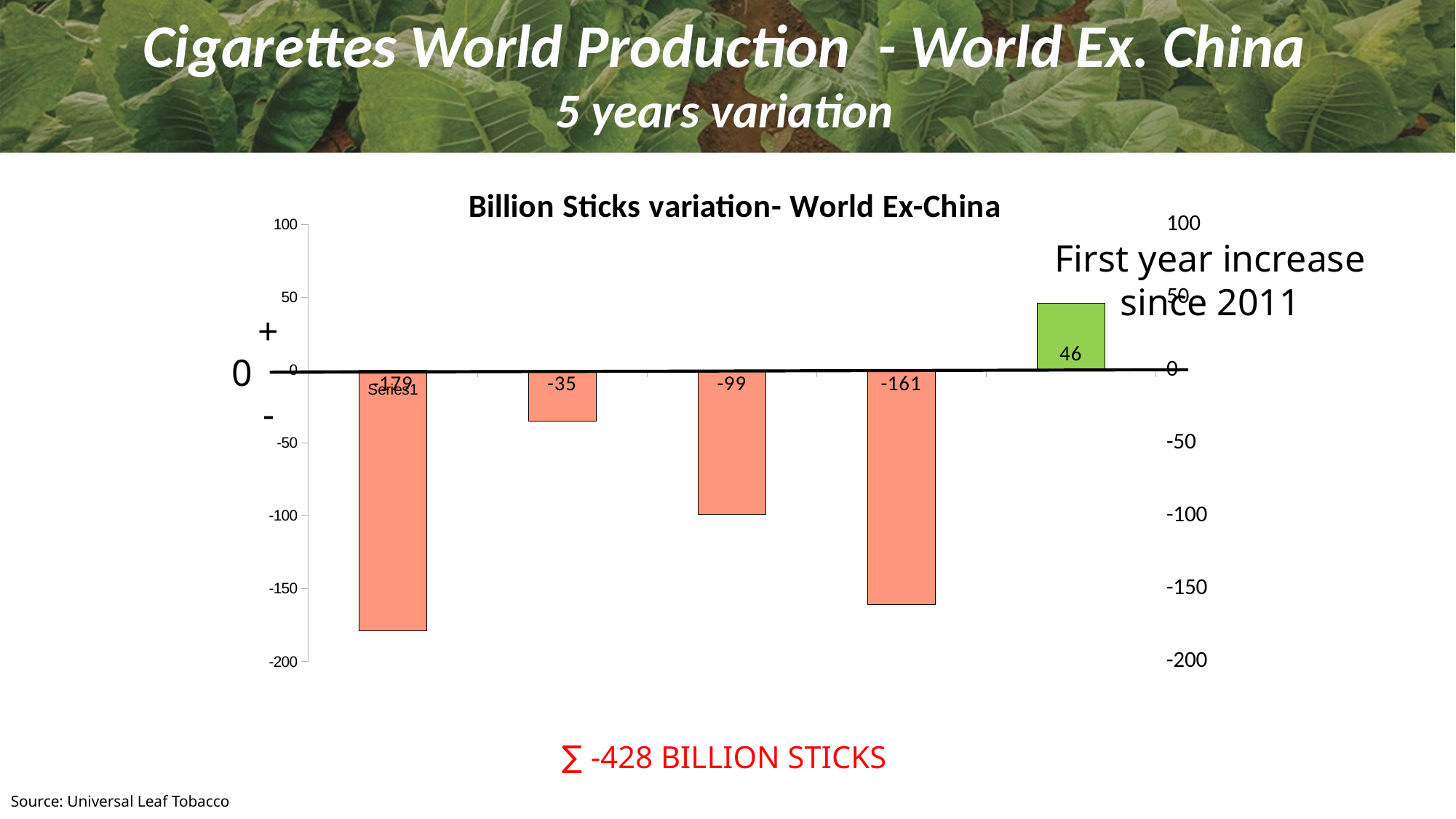
What is the value of the fourth bar from the left in the chart? -161 What is the value of the second bar from the left in the chart? -35 What is the title of the chart? Billion Sticks variation- World Ex-China What is the total of all five bar values shown in the chart? -428 What is the value of the first (leftmost) bar in the chart? -179 What kind of chart is shown on the slide? bar chart Which bar has the highest value in the chart? the rightmost (green) bar, 46 How many bars are plotted in the chart? 5 What is the value of the green bar (the rightmost bar) in the chart? 46 Which is larger, the value of the third bar or the value of the fourth bar? the third bar (-99) Which bar has the lowest value in the chart? the first (leftmost) bar, -179 What is the difference between the third bar (-99) and the second bar (-35)? 64